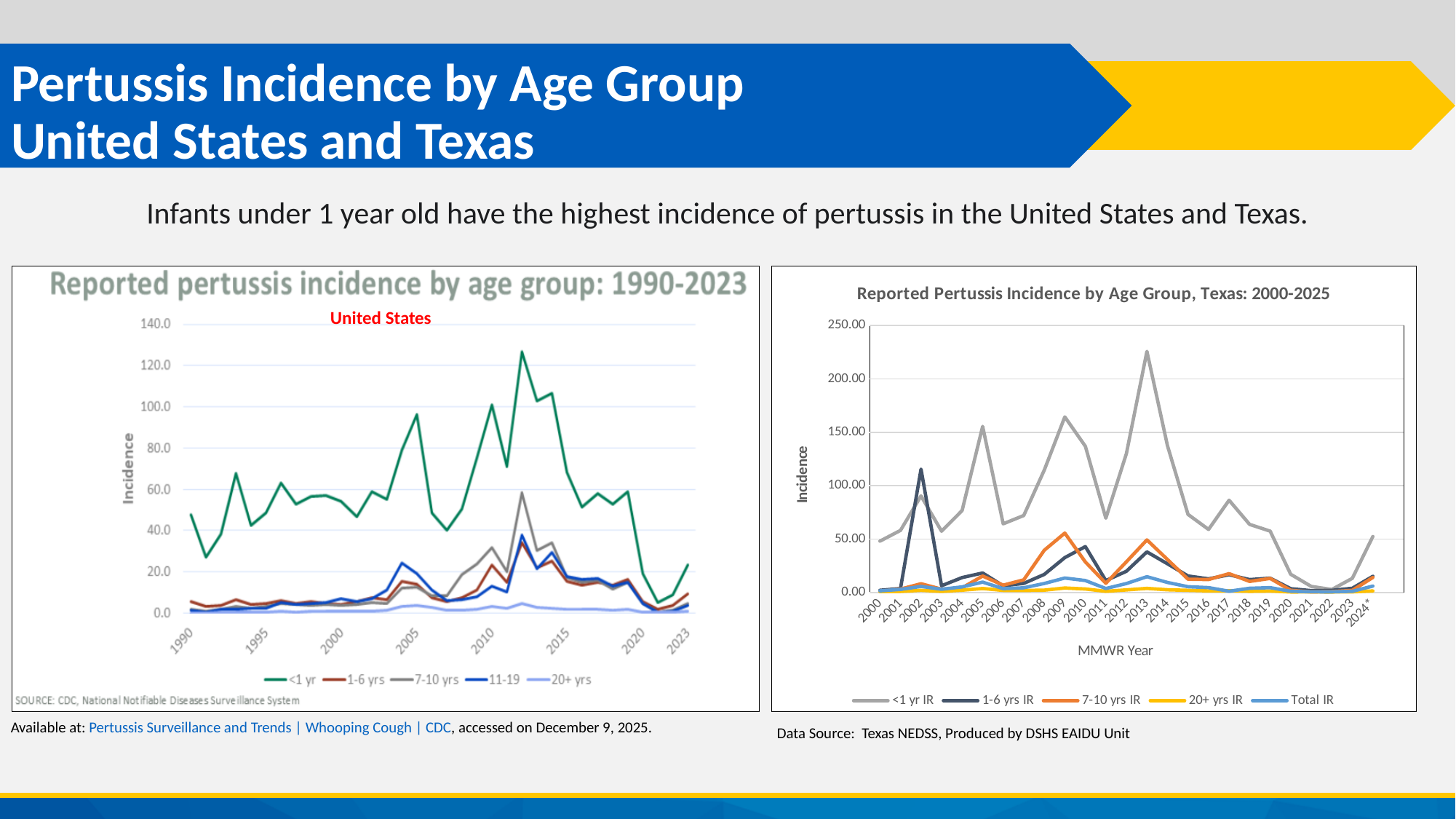
What kind of chart is the left chart, 'Reported pertussis incidence by age group: 1990-2023'? Line chart In the right chart (Texas), is the <1 yr IR value for 2022 greater or less than 50.00? less In the left chart (United States), is the <1 yr value for 2012 greater or less than 120.0? greater How many series does the legend of the right chart (Texas) list? 5 What is the x-axis label of the right chart (Texas)? MMWR Year In the right chart (Texas), is the 1-6 yrs IR value for 2002 greater or less than 100.00? greater How many series does the legend of the left chart (United States) list? 5 What kind of chart is the right chart, 'Reported Pertussis Incidence by Age Group, Texas: 2000-2025'? Line chart In the left chart (United States), which age group has the highest incidence across the years shown? <1 yr In the right chart (Texas), which series reaches the highest incidence? <1 yr IR